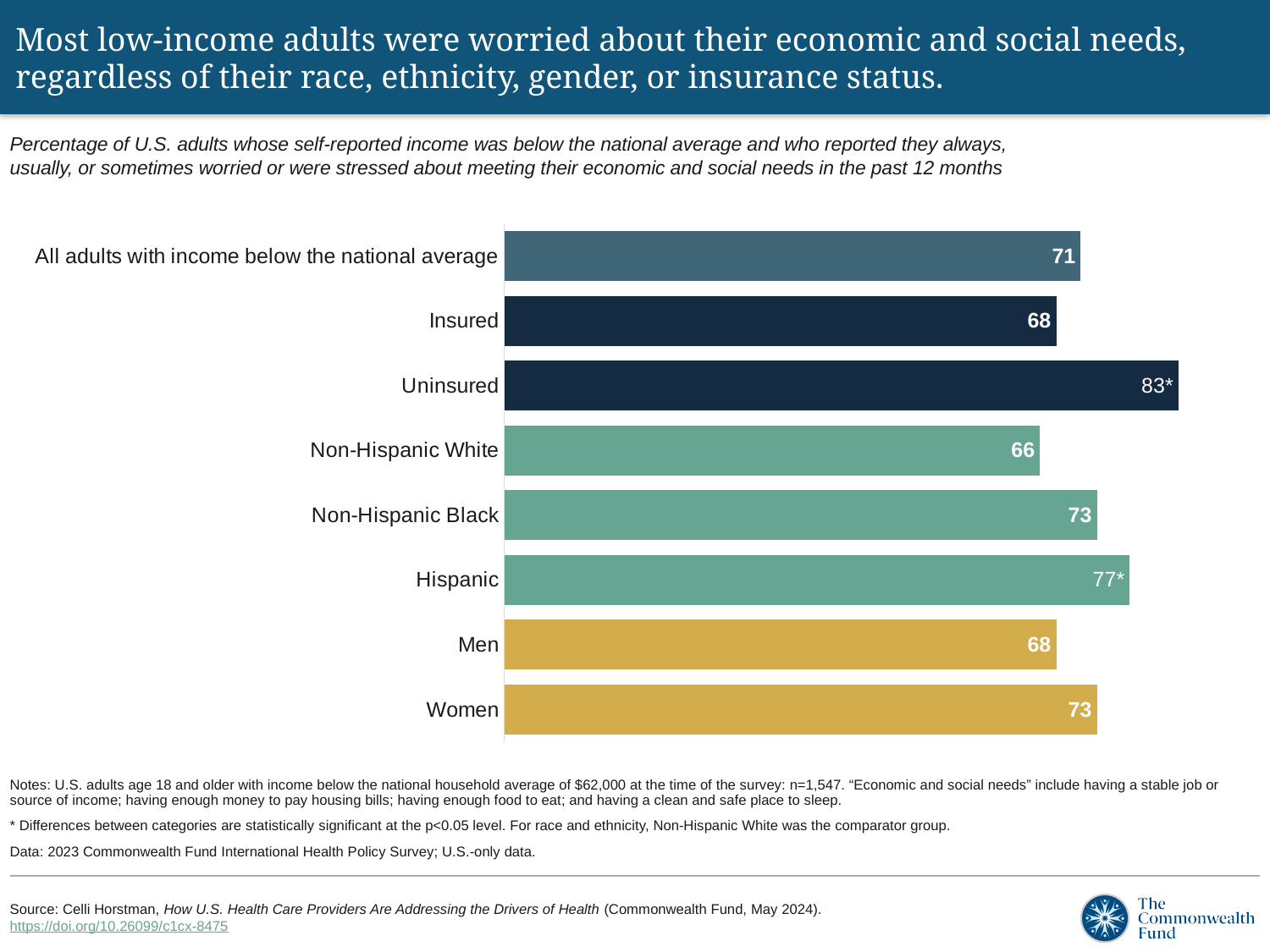
What is the value for All adults with income below the national average? 71 What is the value for Hispanic? 77* How many categories are shown in the chart? 8 Which category has the highest value? Uninsured Which two categories have the same value of 68? Insured and Men Which is larger, the value for Non-Hispanic Black or the value for Non-Hispanic White? Non-Hispanic Black What kind of chart is shown on the slide? Bar chart Which category has the lowest value? Non-Hispanic White What is the value for Uninsured? 83* What is the difference between the values for Women and Men? 5 What is the difference between the values for Uninsured and Insured? 15 What is the value for Non-Hispanic White? 66